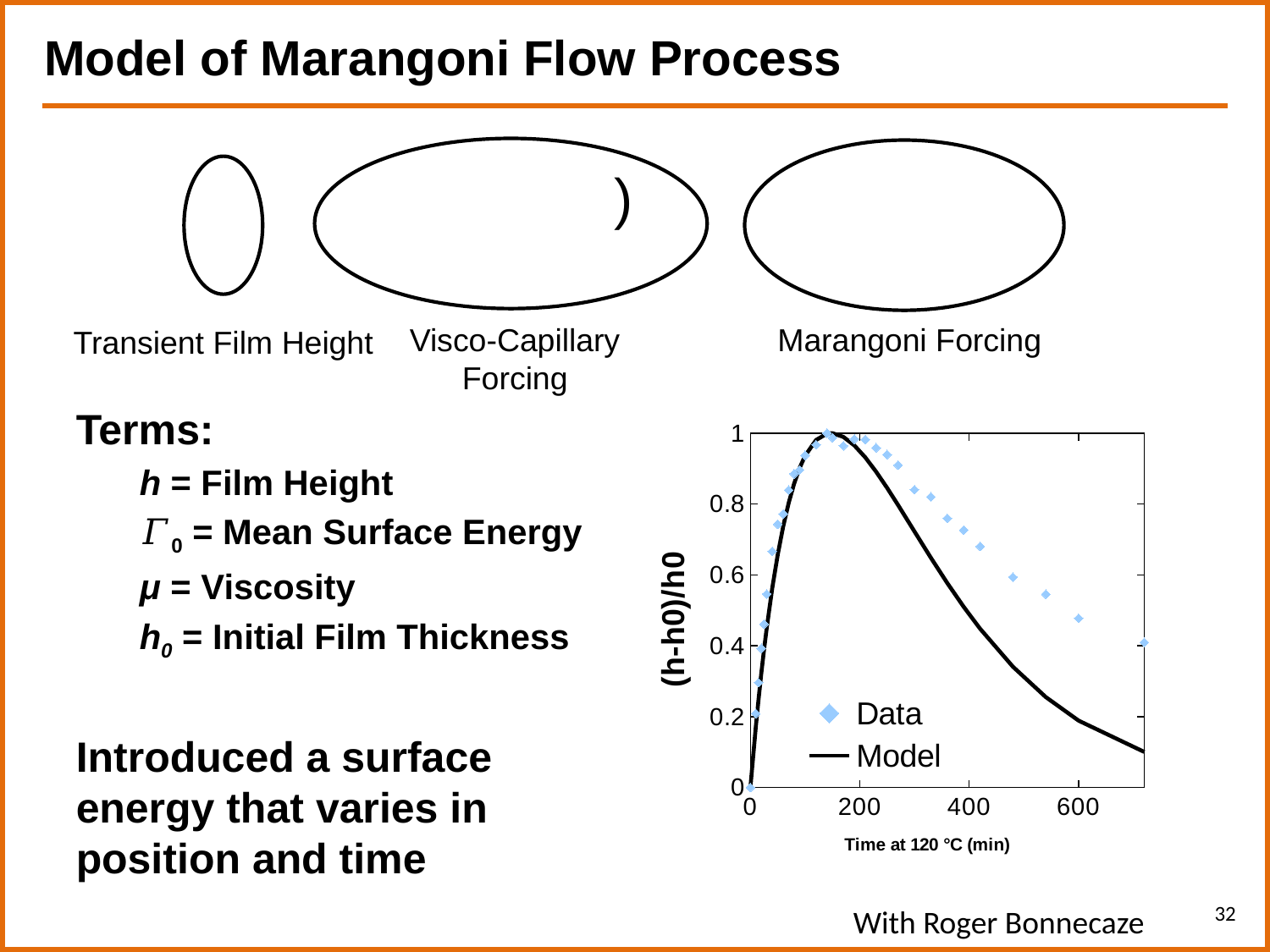
Do the Model values rise or fall between 200 min and 600 min? fall What is the highest tick value shown on the y axis of the chart? 1 Is the Data value at 600 min greater or less than 0.4? greater How many series does the legend of the chart list? 2 What kind of chart is shown on the slide? line chart with scatter points What are the two series named in the chart legend? Data and Model Is the peak Model value greater or less than 0.8? greater What is the label of the x axis of the chart? Time at 120 °C (min) Is the Data value at 400 min greater or less than 0.6? greater At 400 min, which series has the larger value, Data or Model? Data Do the Model values rise or fall between 0 min and 100 min? rise